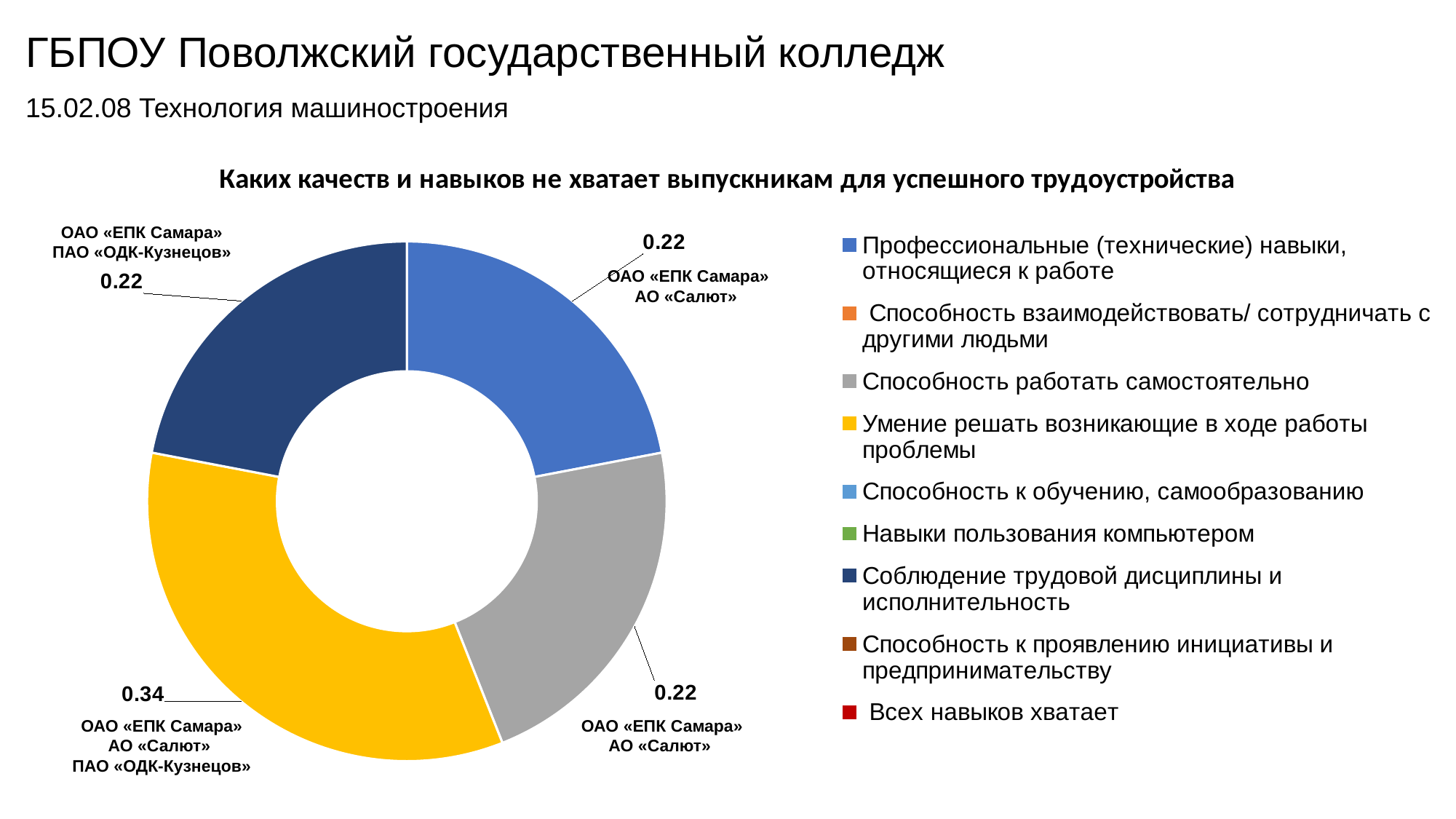
Which is larger: the slice for "Умение решать возникающие в ходе работы проблемы" or the slice for "Профессиональные (технические) навыки, относящиеся к работе"? Умение решать возникающие в ходе работы проблемы What value is shown for the slice "Умение решать возникающие в ходе работы проблемы" (yellow)? 0.34 How many entries does the legend list? 9 What is the difference between the value for "Умение решать возникающие в ходе работы проблемы" and the value for "Способность работать самостоятельно"? 0.12 What value is shown for the slice "Профессиональные (технические) навыки, относящиеся к работе" (blue)? 0.22 What value is shown for the slice "Соблюдение трудовой дисциплины и исполнительность" (dark blue)? 0.22 What value is shown for the slice "Способность работать самостоятельно" (gray)? 0.22 Which category has the largest slice in the chart? Умение решать возникающие в ходе работы проблемы How many slices with data labels are shown in the chart? 4 Which organisations are listed next to the 0.34 slice? ОАО «ЕПК Самара», АО «Салют», ПАО «ОДК-Кузнецов» What is the title of the chart? Каких качеств и навыков не хватает выпускникам для успешного трудоустройства What kind of chart is shown on the slide? doughnut chart